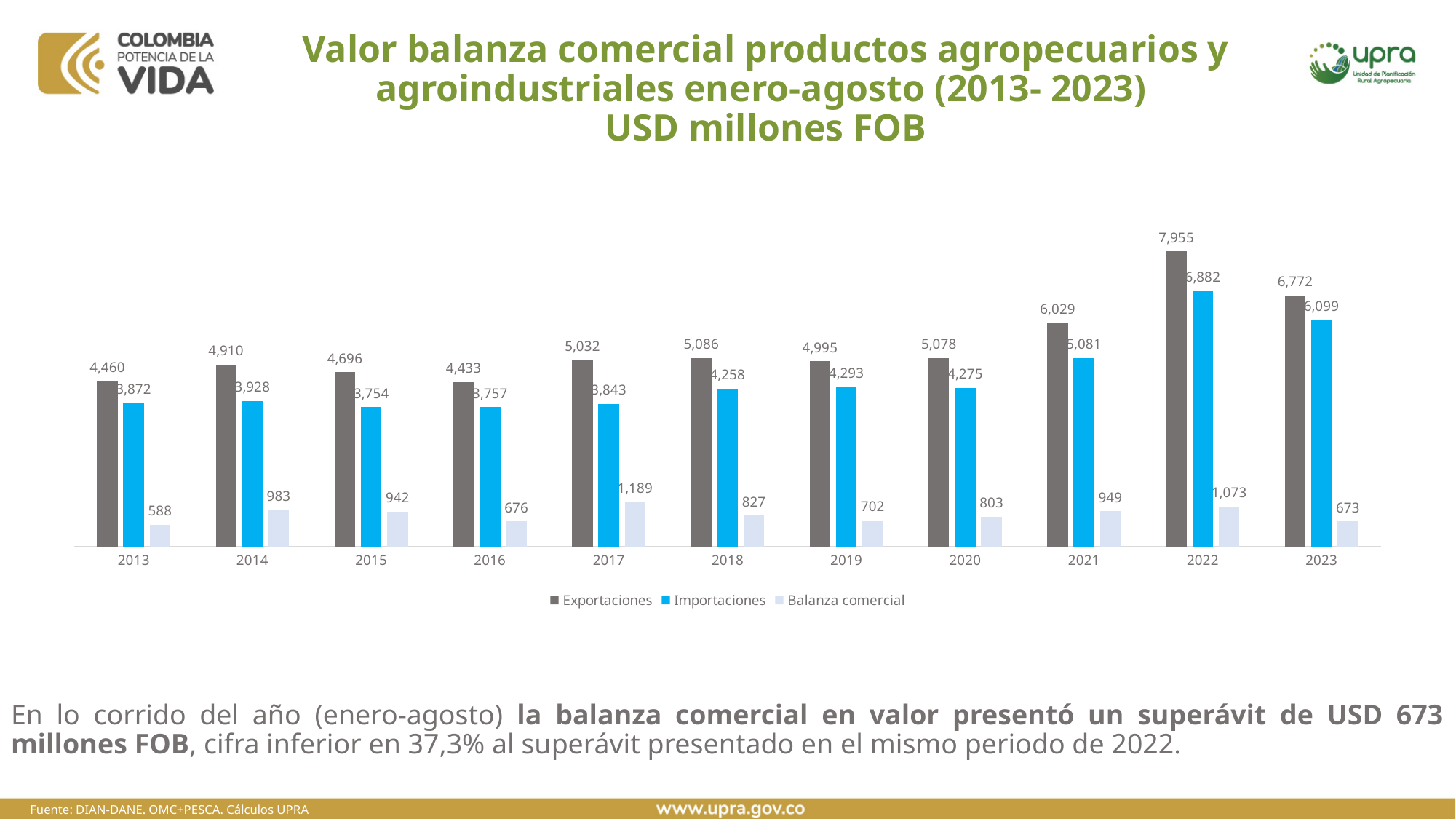
In which year is Exportaciones highest? 2022 Do Exportaciones rise or fall from 2019 to 2022? Rise What is the value of Balanza comercial for 2017? 1,189 Which is larger in 2021, Exportaciones or Importaciones? Exportaciones What is the value of Importaciones for 2022? 6,882 What kind of chart is shown on the slide? Bar chart In which year is Balanza comercial lowest? 2013 What is the value of Exportaciones for 2023? 6,772 By how much did Exportaciones fall from 2022 to 2023? 1,183 What is the difference between Exportaciones and Importaciones in 2023? 673 How many series does the legend list? 3 How many years are shown on the x axis? 11